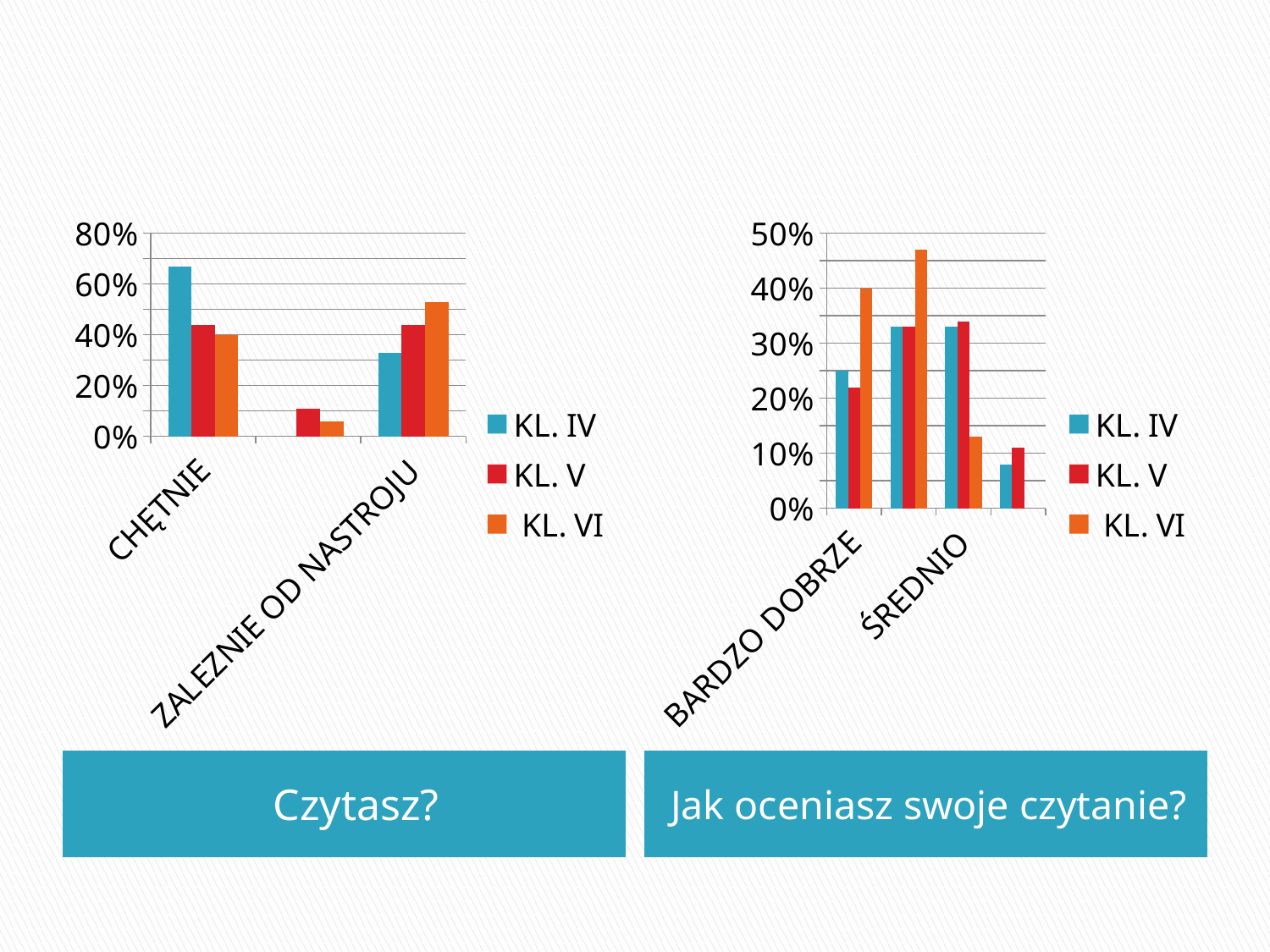
In the 'Jak oceniasz swoje czytanie?' chart, which is larger for BARDZO DOBRZE: KL. IV or KL. VI? KL. VI In the 'Czytasz?' chart, what colour represents the KL. V series? red In the 'Czytasz?' chart, is the value for KL. IV in the CHĘTNIE category greater or less than 60%? greater In the 'Jak oceniasz swoje czytanie?' chart, is the value for KL. VI in the BARDZO DOBRZE category greater or less than 30%? greater What kind of chart is the 'Czytasz?' chart on the left? bar chart How many series does the legend of the 'Czytasz?' chart list? 3 In the 'Jak oceniasz swoje czytanie?' chart, which class has the highest value for ŚREDNIO? KL. V In the 'Czytasz?' chart, is the value for KL. VI in the ZALEŻNIE OD NASTROJU category greater or less than 40%? greater In the 'Czytasz?' chart, which class has the highest value for CHĘTNIE? KL. IV What is the title shown under the chart on the right? Jak oceniasz swoje czytanie? In the 'Czytasz?' chart, which class has the highest value for ZALEŻNIE OD NASTROJU? KL. VI In the 'Czytasz?' chart, which is larger for CHĘTNIE: KL. IV or KL. VI? KL. IV